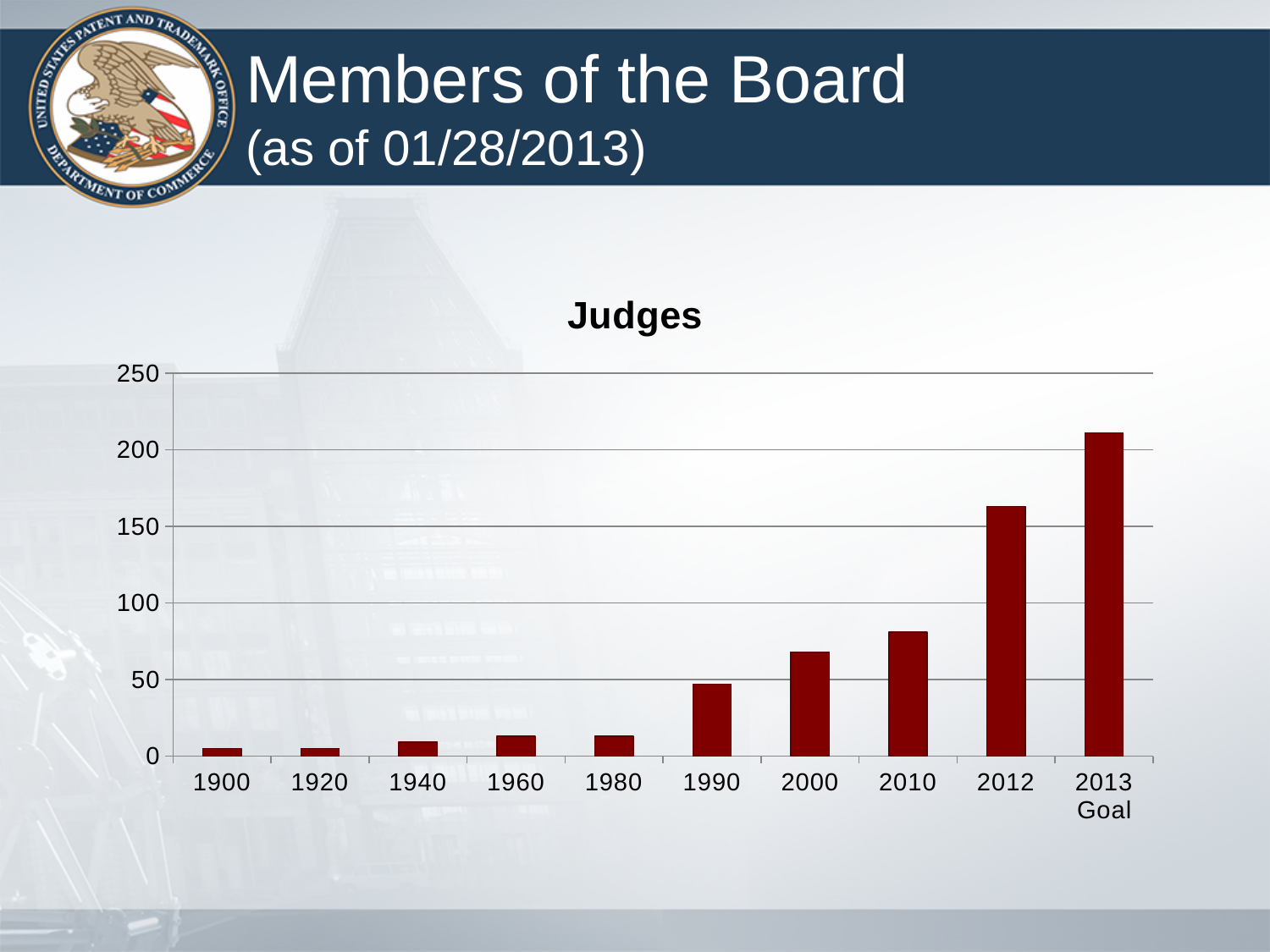
Is the value for 2010 greater or less than 100? less Is the value for 2012 greater or less than 150? greater How many categories are shown along the x axis of the chart? 10 Do the values generally rise or fall from 1900 to 2013 Goal along the x axis? rise Is the value for 2013 Goal greater or less than 200? greater What is the title of the chart? Judges Which has a larger value, 2012 or 2010? 2012 Which category has the highest value in the chart? 2013 Goal What kind of chart is shown on the slide? Bar chart Which has a larger value, 1990 or 2000? 2000